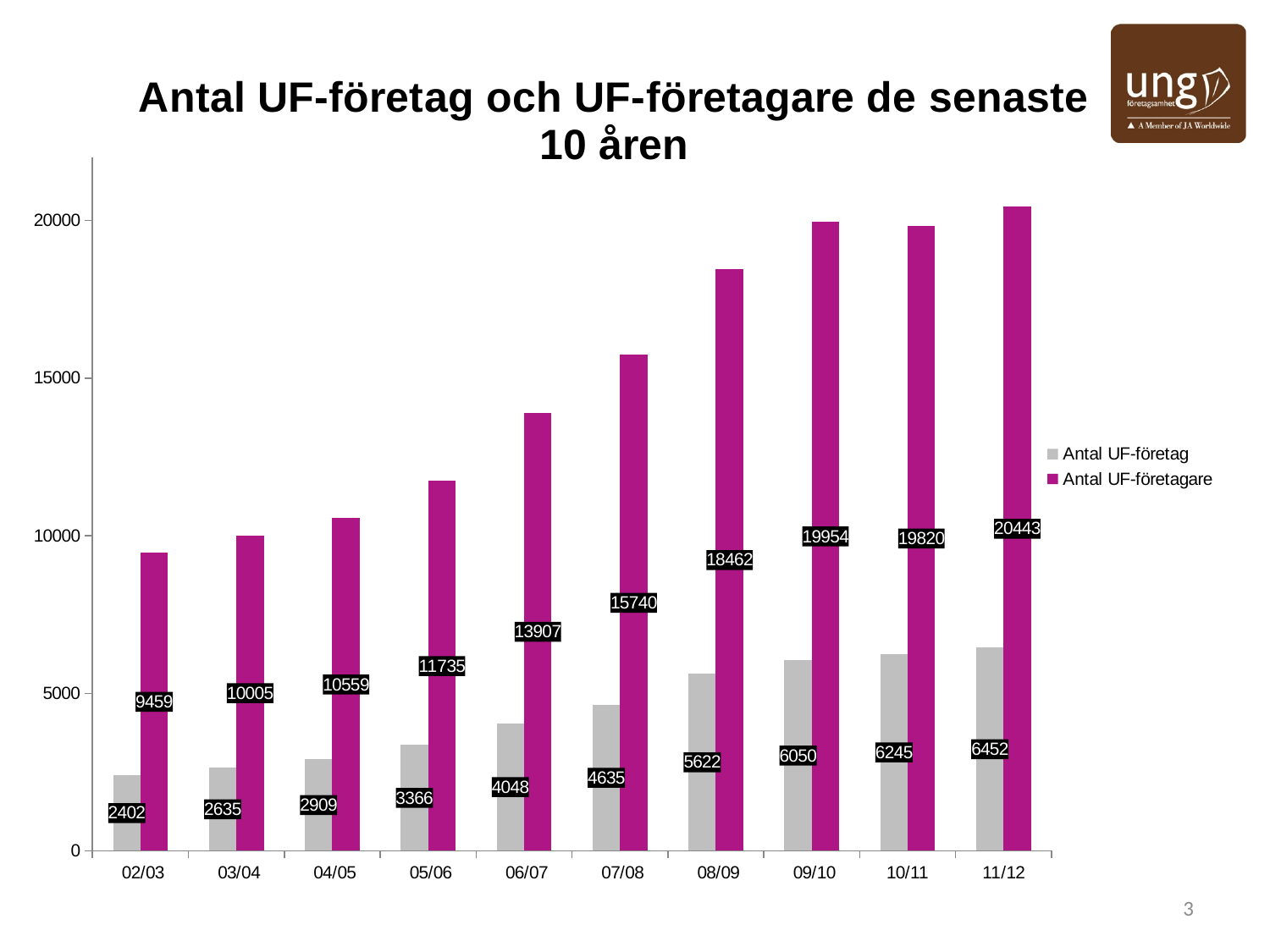
What is the value of Antal UF-företagare for 06/07? 13907 What is the difference in Antal UF-företag between 10/11 and 09/10? 195 Which is larger, Antal UF-företagare in 09/10 or in 10/11? 09/10 What is the difference between Antal UF-företagare and Antal UF-företag in 11/12? 13991 What kind of chart is shown on the slide? Bar chart Is the value of Antal UF-företagare for 07/08 greater or less than 15000? greater What is the value of Antal UF-företag for 02/03? 2402 Which year has the highest value for Antal UF-företagare? 11/12 Which year has the lowest value for Antal UF-företag? 02/03 How many years are shown on the x axis? 10 What is the value of Antal UF-företagare for 11/12? 20443 How many series does the legend list? 2